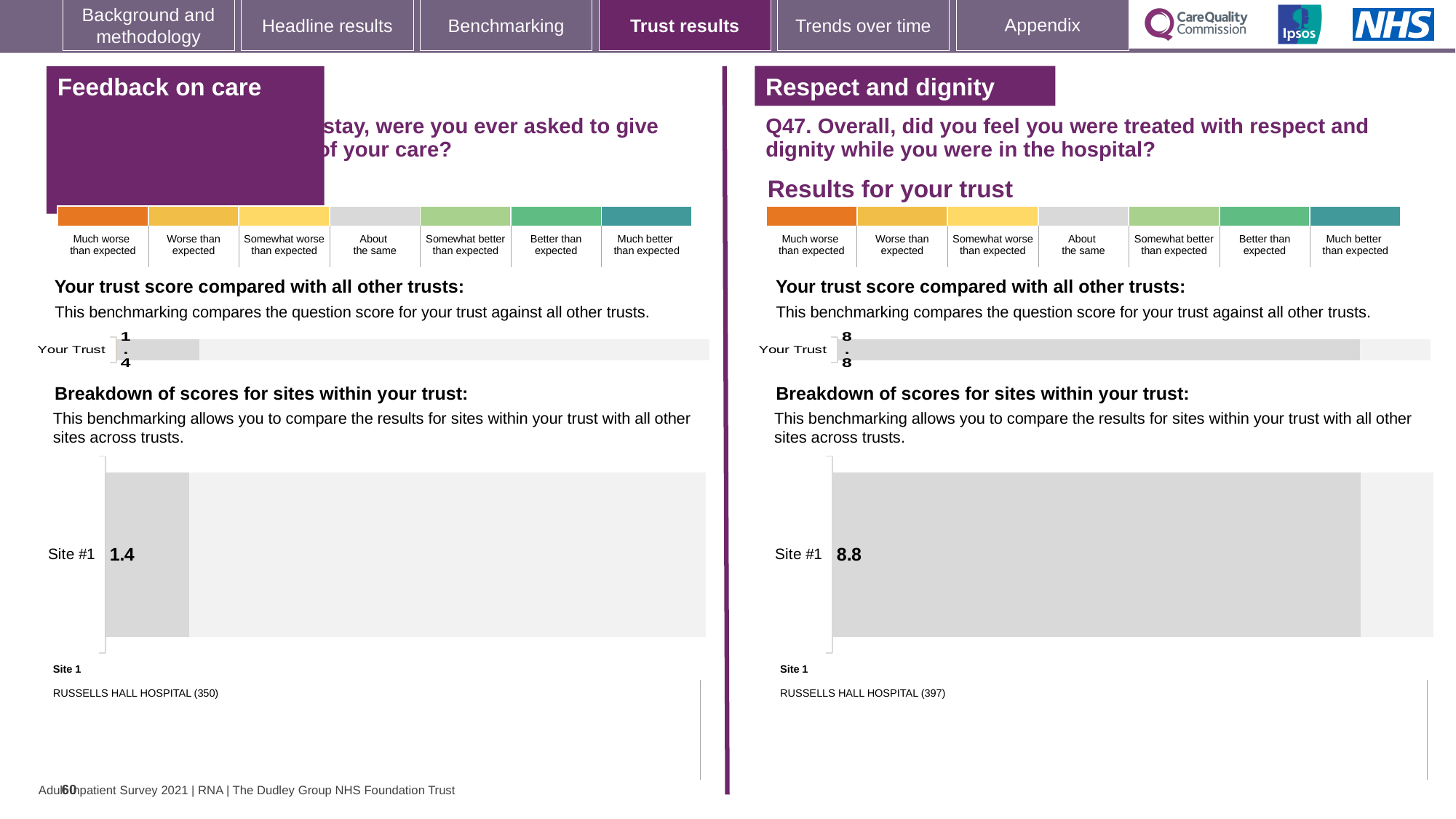
Is the Your Trust score in the 'Feedback on care' section greater or less than 5? less Which is larger: the Site #1 score in the 'Feedback on care' section or the Site #1 score in the 'Respect and dignity' section? Respect and dignity How many sites are shown in the 'Breakdown of scores for sites within your trust' chart in the 'Respect and dignity' section? 1 On the 'Respect and dignity' section, what is the score shown for Your Trust in the 'Your trust score compared with all other trusts' chart? 8.8 Is the Your Trust score in the 'Respect and dignity' section greater or less than 5? greater On the 'Respect and dignity' section, what is the score shown for Site #1 in the 'Breakdown of scores for sites within your trust' chart? 8.8 What is the difference between the Site #1 score in the 'Respect and dignity' section and the Site #1 score in the 'Feedback on care' section? 7.4 On the 'Feedback on care' section, what is the score shown for Your Trust in the 'Your trust score compared with all other trusts' chart? 1.4 In the 'Feedback on care' section, which site is listed as Site 1 below the breakdown chart? RUSSELLS HALL HOSPITAL (350) On the 'Feedback on care' section, what is the score shown for Site #1 in the 'Breakdown of scores for sites within your trust' chart? 1.4 In the 'Respect and dignity' section, which site is listed as Site 1 below the breakdown chart? RUSSELLS HALL HOSPITAL (397) What type of chart is used to show the Site #1 score in the 'Feedback on care' section? Bar chart